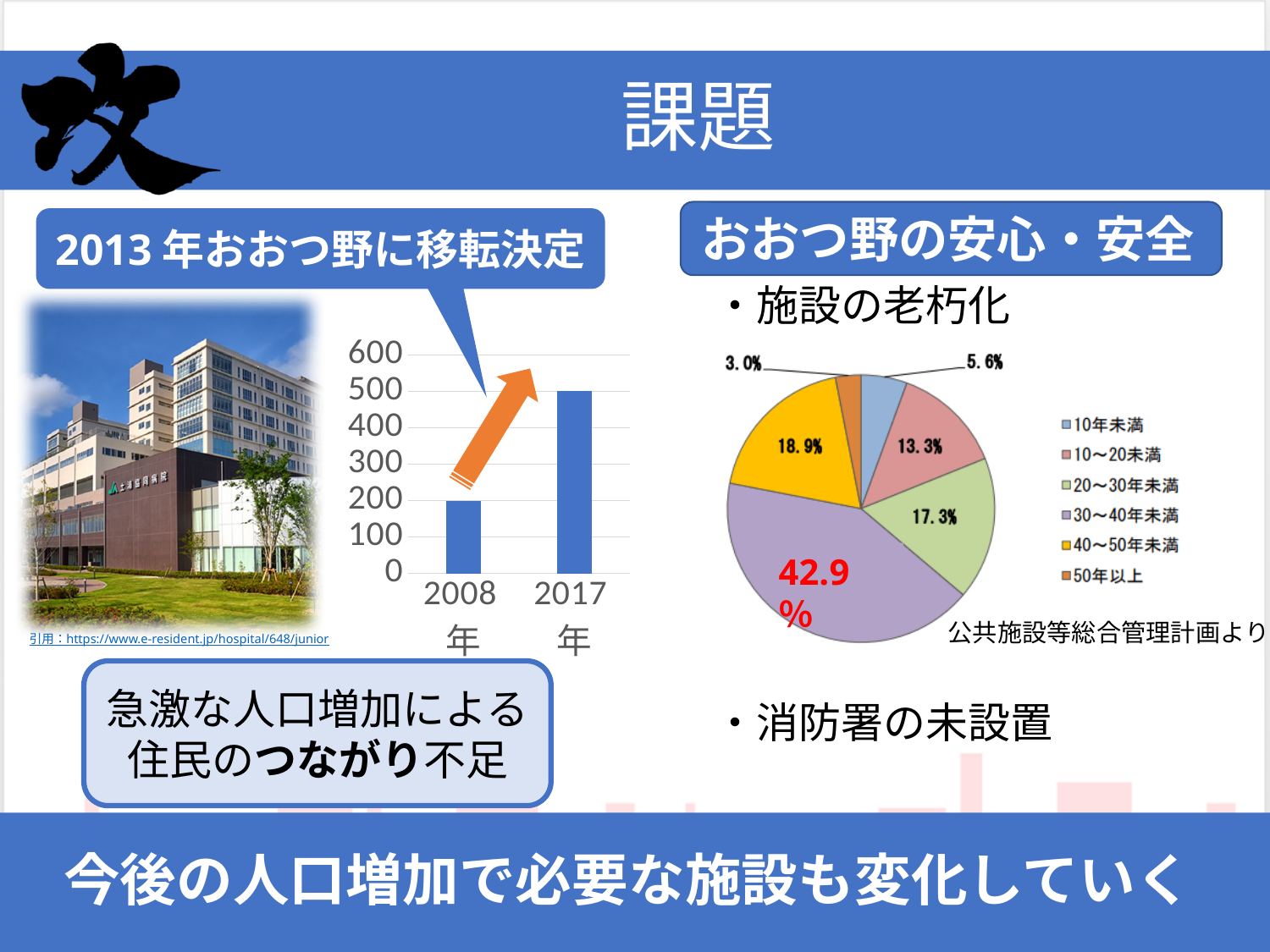
In the pie chart on the right, what share does the 30～40年未満 slice have? 42.9% In the pie chart on the right, what share does the 40～50年未満 slice have? 18.9% In the pie chart on the right, which category has the smallest share? 50年以上 In the bar chart on the left, what is the value for 2008年? 200 In the bar chart on the left, what is the difference between the values for 2017年 and 2008年? 300 In the bar chart on the left, which year has the higher value, 2008年 or 2017年? 2017年 What kind of chart is shown on the left side of the slide? bar chart How many entries does the legend of the pie chart on the right list? 6 In the bar chart on the left, do the values rise or fall from 2008年 to 2017年? rise In the bar chart on the left, what is the value for 2017年? 500 In the pie chart on the right, which category has the largest share? 30～40年未満 In the bar chart on the left, how many bars are plotted? 2